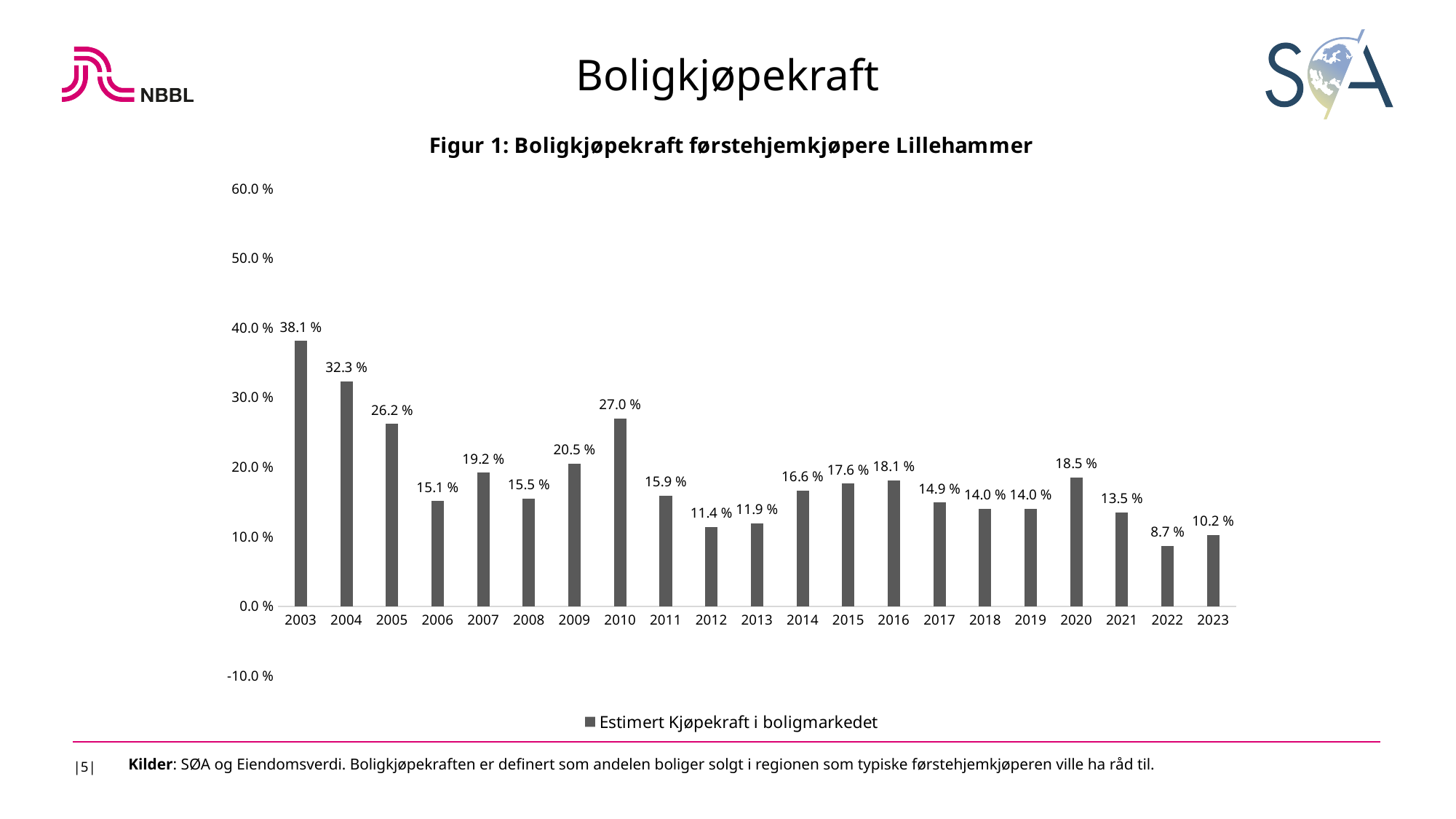
Which year has the lowest value? 2022 What is the legend entry for the series? Estimert Kjøpekraft i boligmarkedet What is the value for 2010? 27.0 % How many years are shown on the x axis? 21 What is the difference between the values for 2003 and 2023? 27.9 % What kind of chart is shown? bar chart Which is larger, the value for 2009 or the value for 2011? 2009 How many series does the legend list? 1 Which year has the highest value? 2003 What is the value for 2023? 10.2 % Is the value for 2004 greater or less than 30.0 %? greater What is the value for 2003? 38.1 %